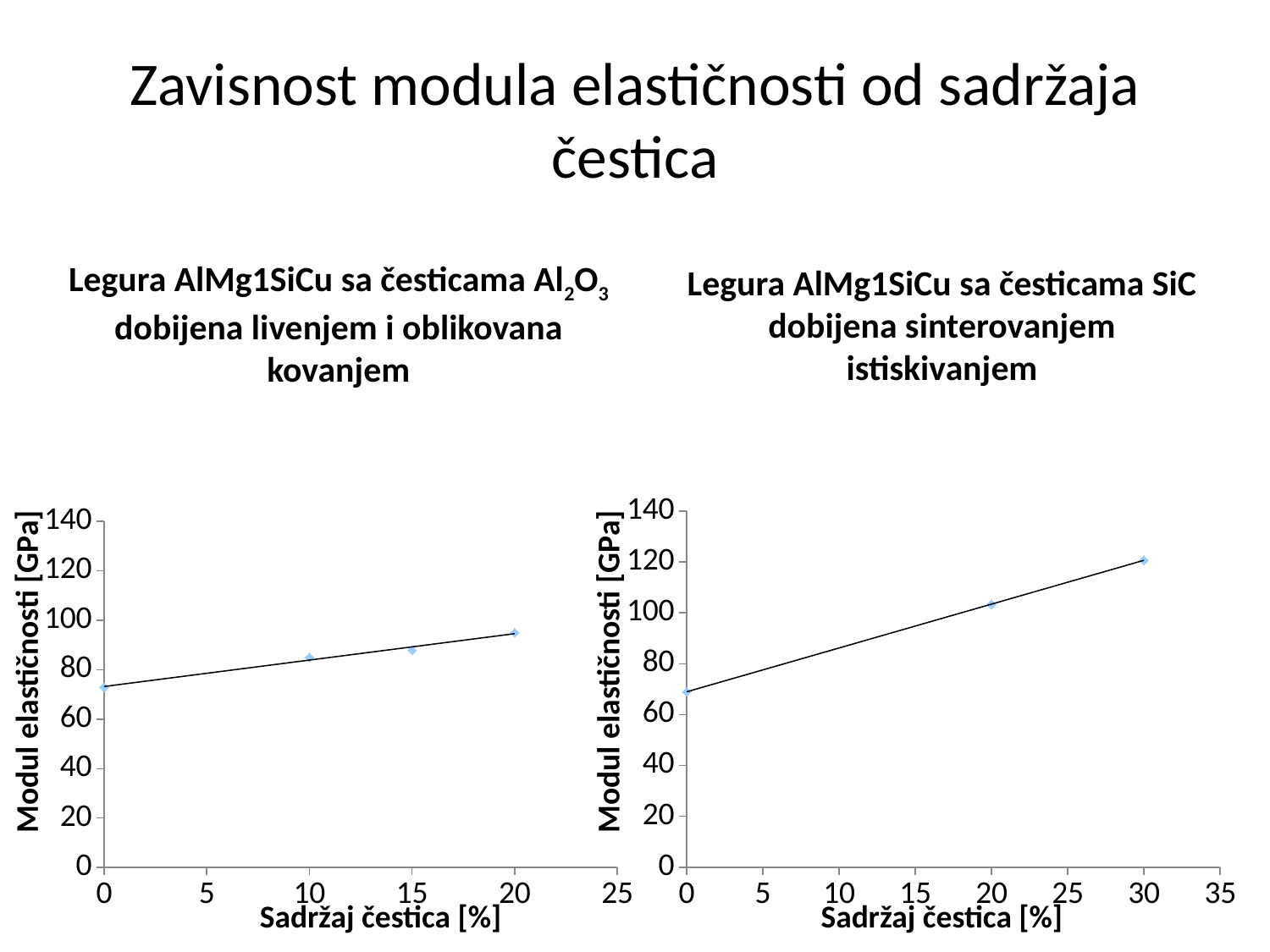
What is the y-axis title on the right chart (SiC particles)? Modul elastičnosti [GPa] On the right chart (SiC particles), does the modulus of elasticity rise or fall as the particle content increases? rise On the right chart (SiC particles), at which particle content is the modulus of elasticity highest? 30 On the left chart (Al2O3 particles), does the modulus of elasticity rise or fall as the particle content increases? rise How many data points are plotted on the left chart (Al2O3 particles)? 4 On the left chart (Al2O3 particles), which has the larger modulus of elasticity: 0% or 20% particle content? 20% What kind of chart is the left chart (Legura AlMg1SiCu sa česticama Al2O3)? scatter chart with a trend line On the left chart (Al2O3 particles), is the value at 20% particle content greater or less than 80? greater On the left chart (Al2O3 particles), is the value at 0% particle content greater or less than 80? less How many data points are plotted on the right chart (SiC particles)? 3 On the right chart (SiC particles), is the value at 0% particle content greater or less than 80? less